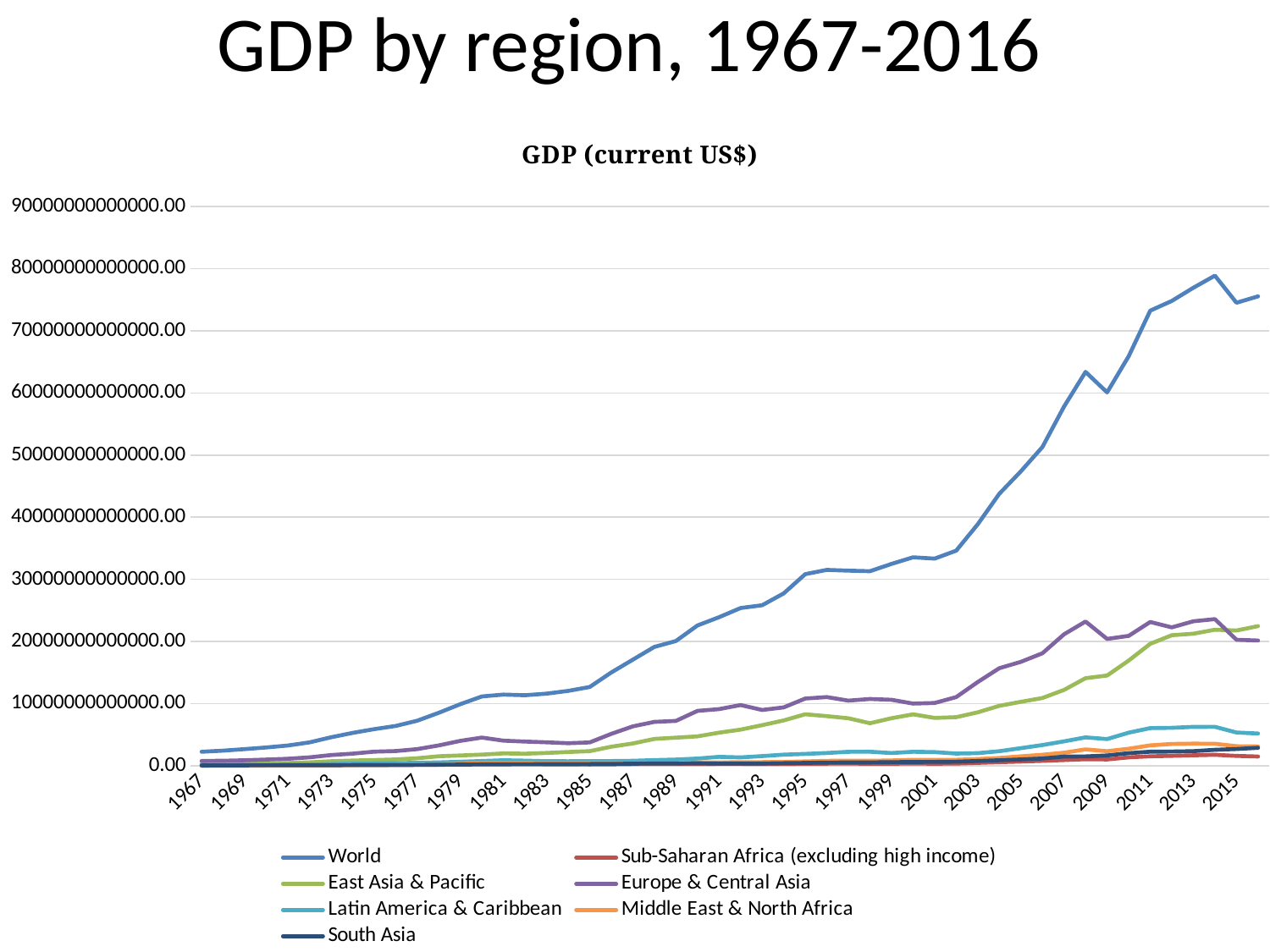
How many series does the legend list? 7 Which series has the highest values throughout the chart? World What kind of chart is shown on the slide? line chart What is the first year label on the x axis? 1967 Which series has the lowest value in 2016? Sub-Saharan Africa (excluding high income) Is the value for World in 2000 greater or less than 300000000000000.00? greater What is the title printed above the chart area? GDP (current US$) Is the value for Europe & Central Asia in 2008 greater or less than 200000000000000.00? greater Is the value for World in 1967 greater or less than 100000000000000.00? less In 2016, which is larger: East Asia & Pacific or Europe & Central Asia? East Asia & Pacific Does the World series generally rise or fall from 1967 to 2016? rise